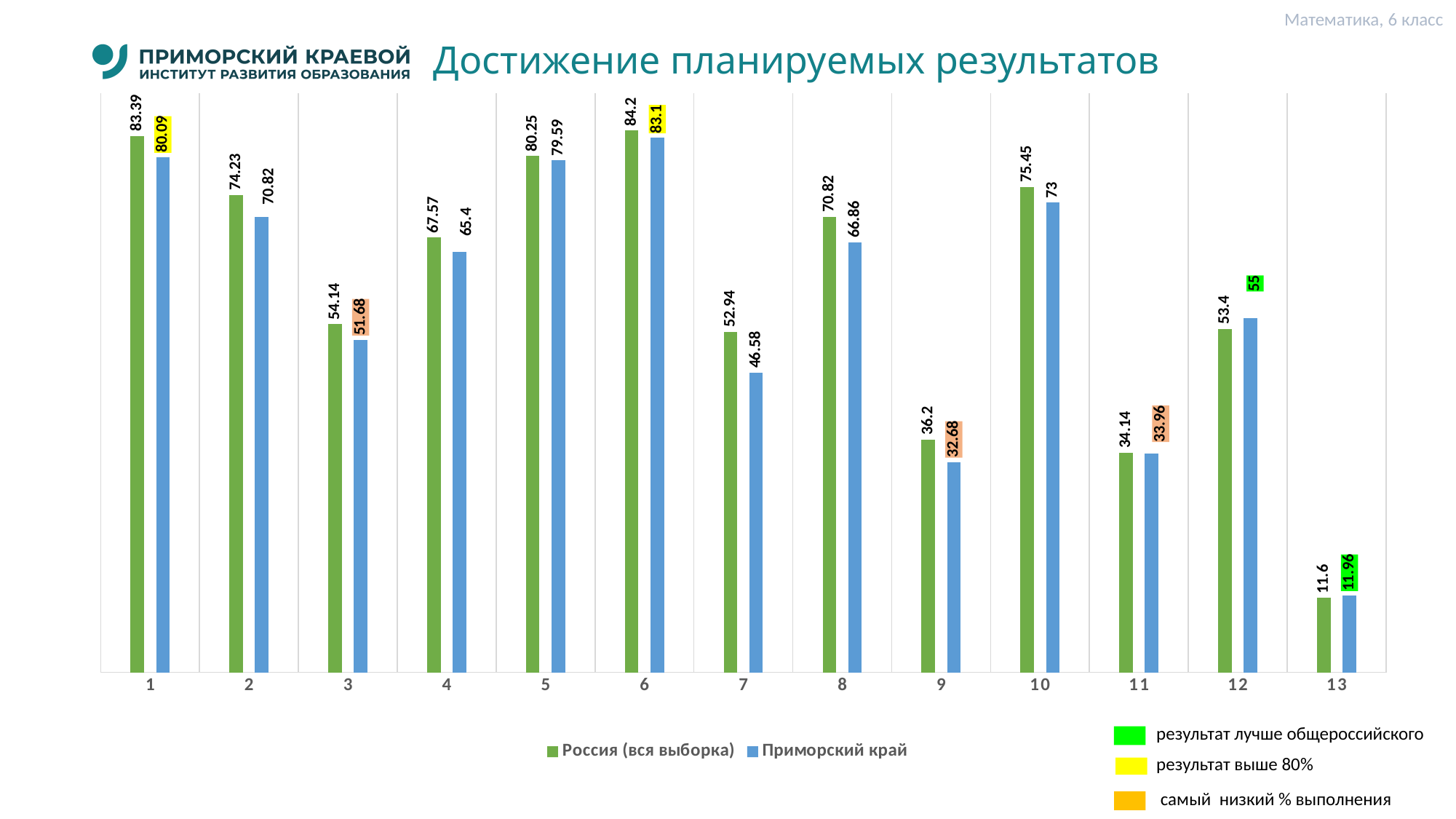
How many categories are shown on the x axis of the chart? 13 What is the difference between Россия (вся выборка) and Приморский край in category 7? 6.36 In category 12, which series has the larger value, Россия (вся выборка) or Приморский край? Приморский край Which category has the lowest value for Приморский край? 13 How many series does the chart legend list? 2 What is the value for Россия (вся выборка) in category 7? 52.94 What type of chart is shown on the slide? bar chart What is the value for Приморский край in category 10? 73 What is the difference between Приморский край and Россия (вся выборка) in category 13? 0.36 What is the title of the chart on the slide? Достижение планируемых результатов Which category has the highest value for Россия (вся выборка)? 6 What is the value for Приморский край in category 1? 80.09